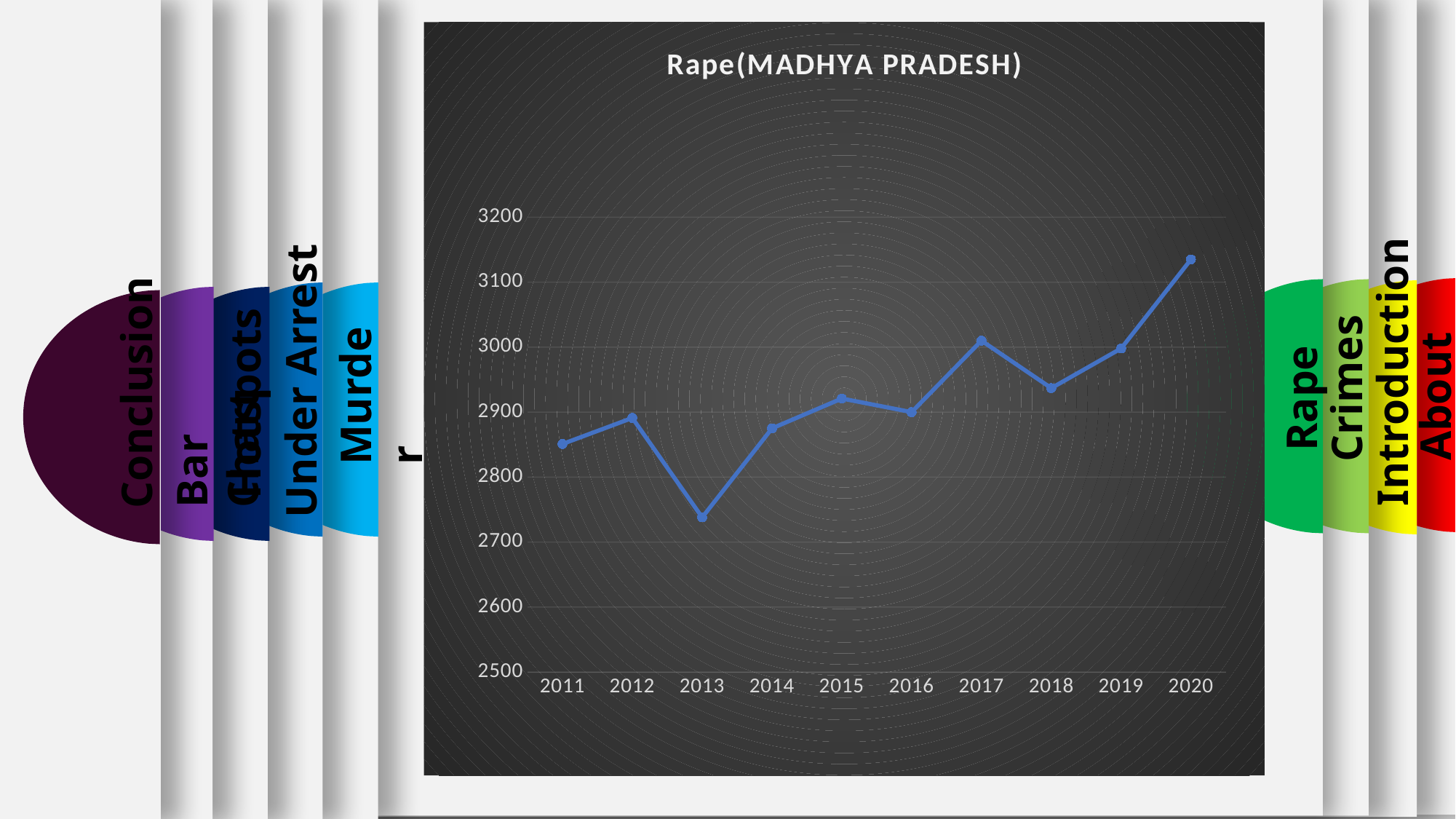
Which year has the larger value, 2011 or 2020? 2020 Do the values rise or fall from 2018 to 2020? rise Which year has the larger value, 2013 or 2014? 2014 Is the value for 2018 greater or less than 2900? greater Is the value for 2011 greater or less than 2900? less Which year has the highest value in the chart? 2020 Which year has the lowest value in the chart? 2013 How many years are plotted on the x axis of the chart? 10 Is the value for 2020 greater or less than 3100? greater What kind of chart is shown on the slide? line chart What is the title of the chart? Rape(MADHYA PRADESH)